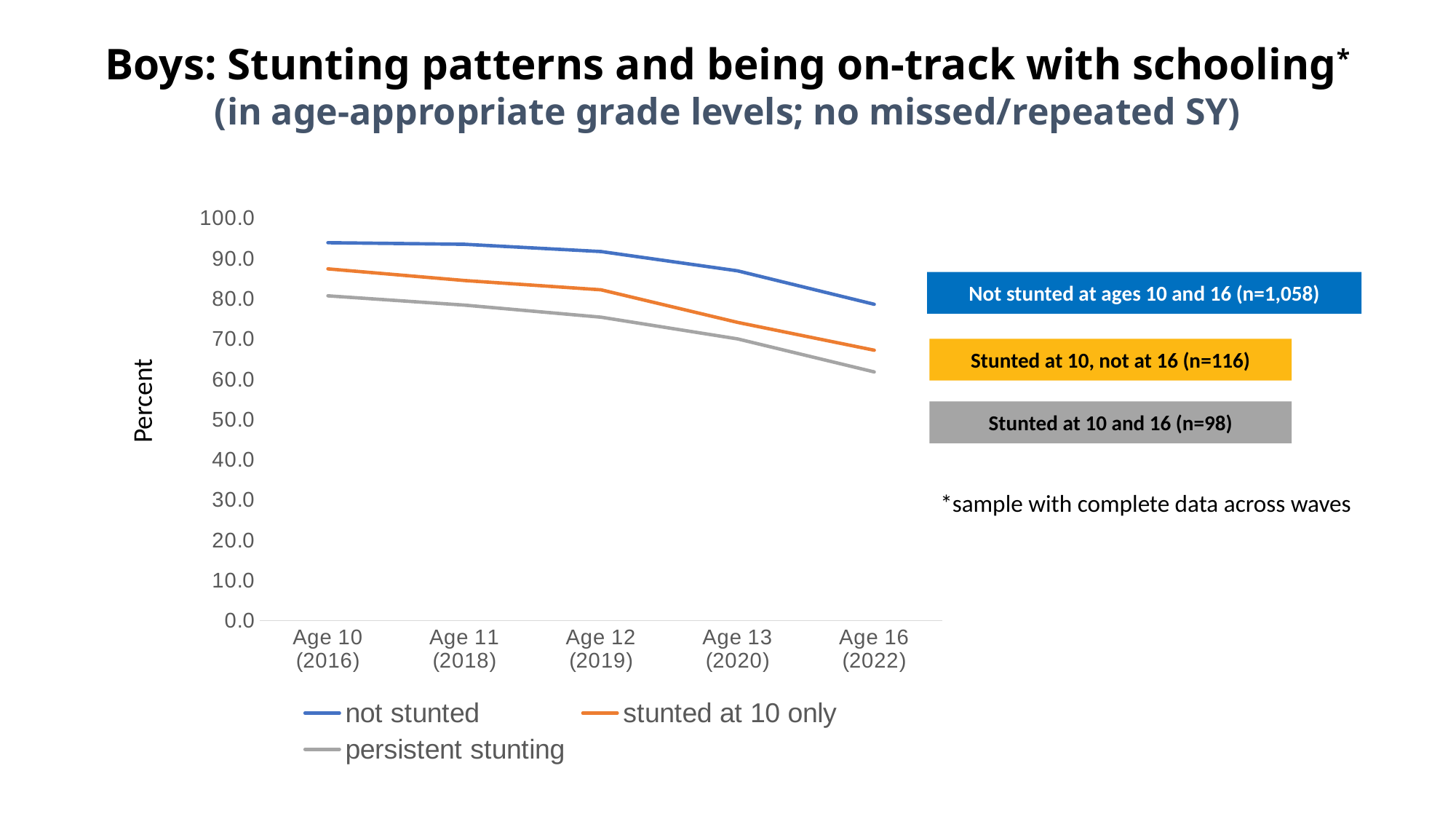
Do the values for the 'not stunted' series rise or fall from Age 10 to Age 16? fall Is the value for 'not stunted' at Age 10 (2016) greater or less than 90? greater Is the value for 'persistent stunting' at Age 16 (2022) greater or less than 70? less What kind of chart is shown on the slide? line chart What is the label on the y axis? Percent According to the box on the right, what is the sample size for boys stunted at 10 and 16? n=98 Which series has the highest value at Age 16 (2022)? not stunted How many age points are plotted along the x axis? 5 Which series has the lowest value at Age 10 (2016)? persistent stunting Is the value for 'stunted at 10 only' at Age 16 (2022) greater or less than 80? less At Age 13 (2020), which is larger: the value for 'not stunted' or for 'persistent stunting'? not stunted How many series does the legend list? 3